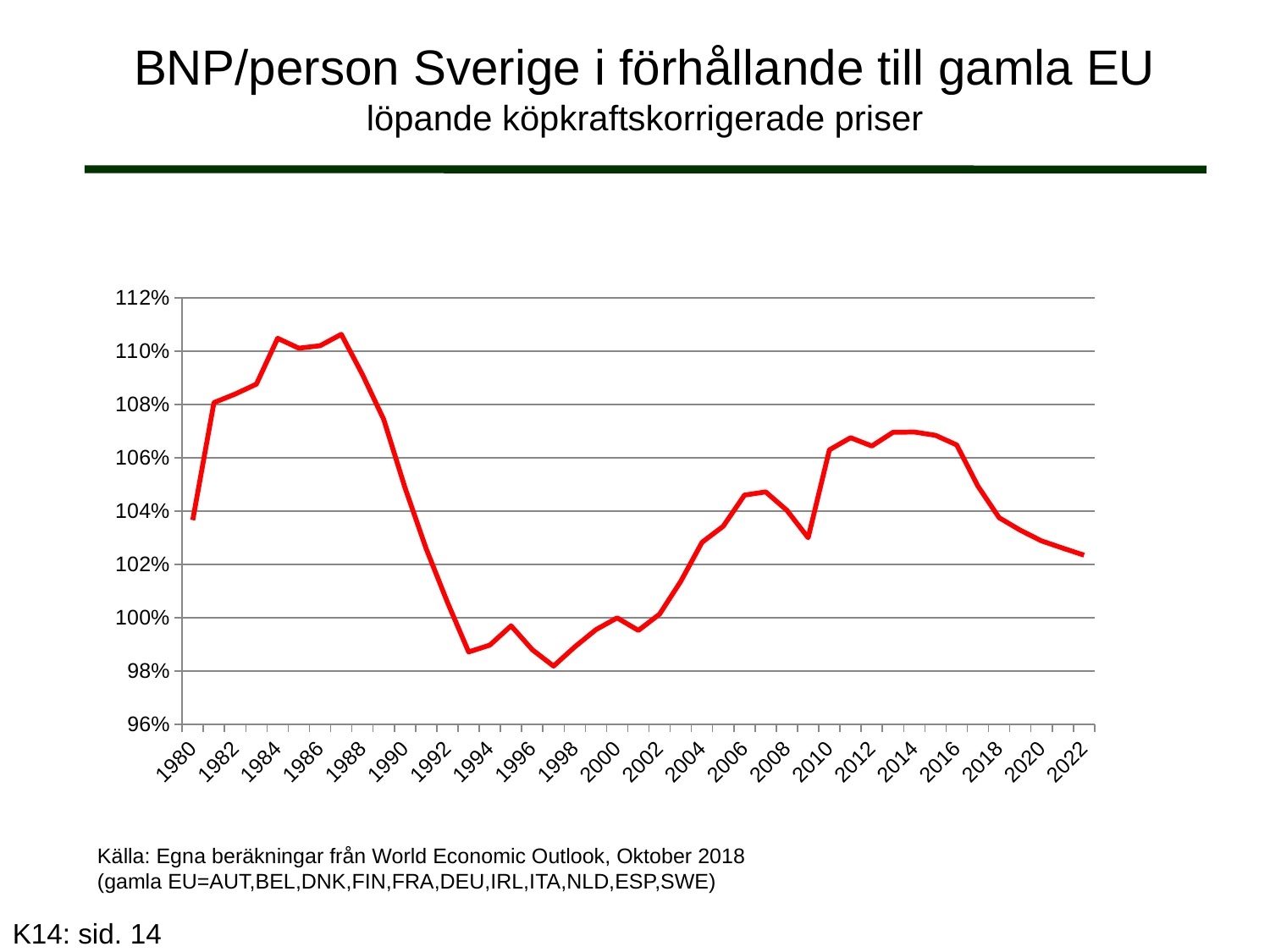
Which year has the higher value, 1984 or 1994? 1984 In which year does the line reach its lowest value? 1997 Is the value for 2022 greater or less than 104%? less Does the line rise or fall between 1987 and 1993? fall Is the value for 1990 greater or less than 104%? greater Is the value for 1997 greater or less than 100%? less What is the title of the chart on the slide? BNP/person Sverige i förhållande till gamla EU What colour is the line plotted in the chart? red What kind of chart is shown on the slide? line chart Does the line rise or fall between 2002 and 2007? rise